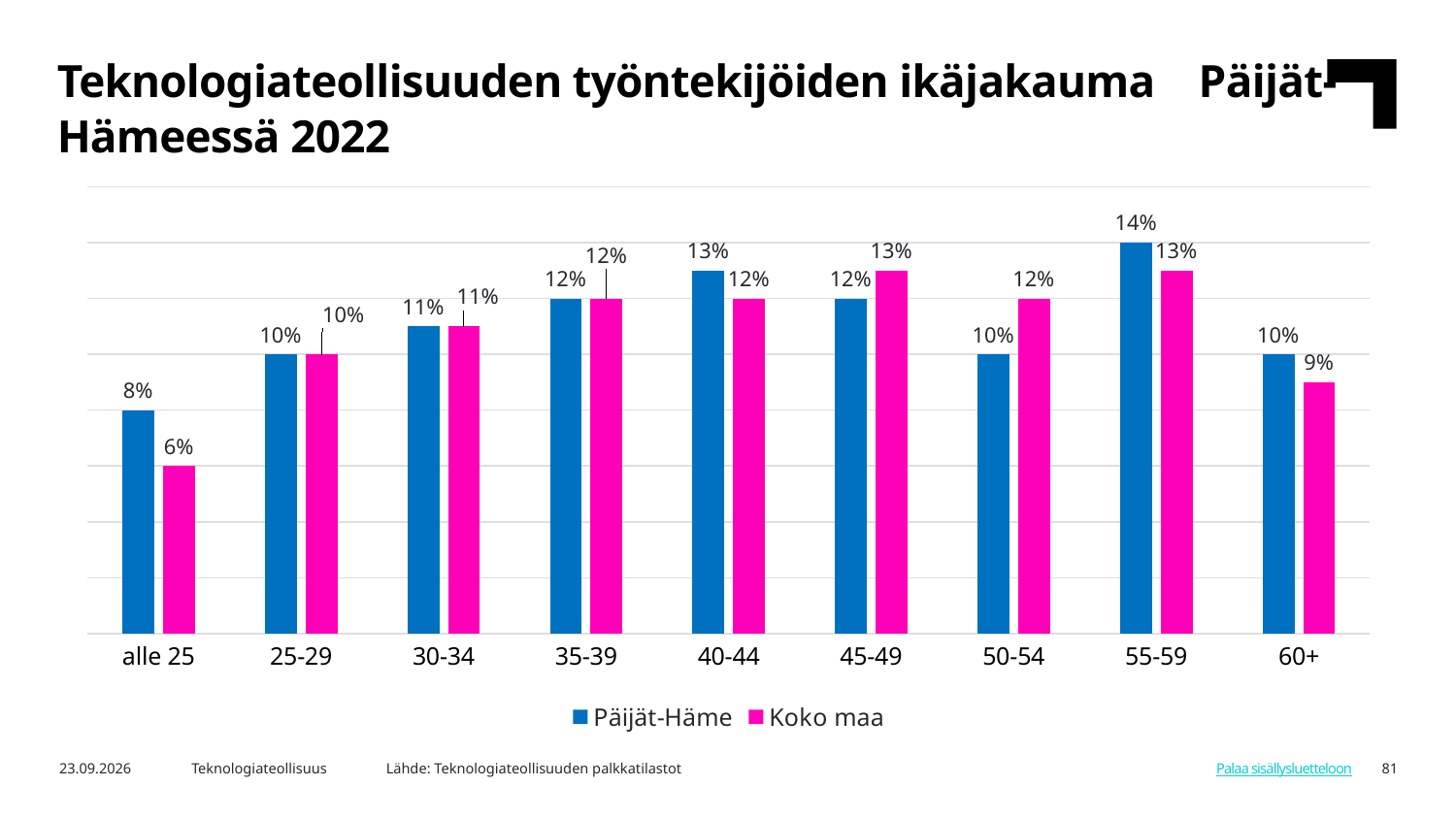
How many age groups are shown on the x axis? 9 What is the value for Koko maa in the 50-54 age group? 12% Which age group has the lowest value for Koko maa? alle 25 Which age group has the highest value for Päijät-Häme? 55-59 What is the value for Päijät-Häme in the alle 25 age group? 8% What is the difference between the Päijät-Häme values for 55-59 and 50-54? 4% Which colour represents the Koko maa series? Pink In the 50-54 age group, which series has the larger value, Päijät-Häme or Koko maa? Koko maa What is the value for Koko maa in the 60+ age group? 9% What kind of chart is shown on the slide? Bar chart What is the difference between the Päijät-Häme and Koko maa values in the alle 25 age group? 2% How many series does the legend list? 2